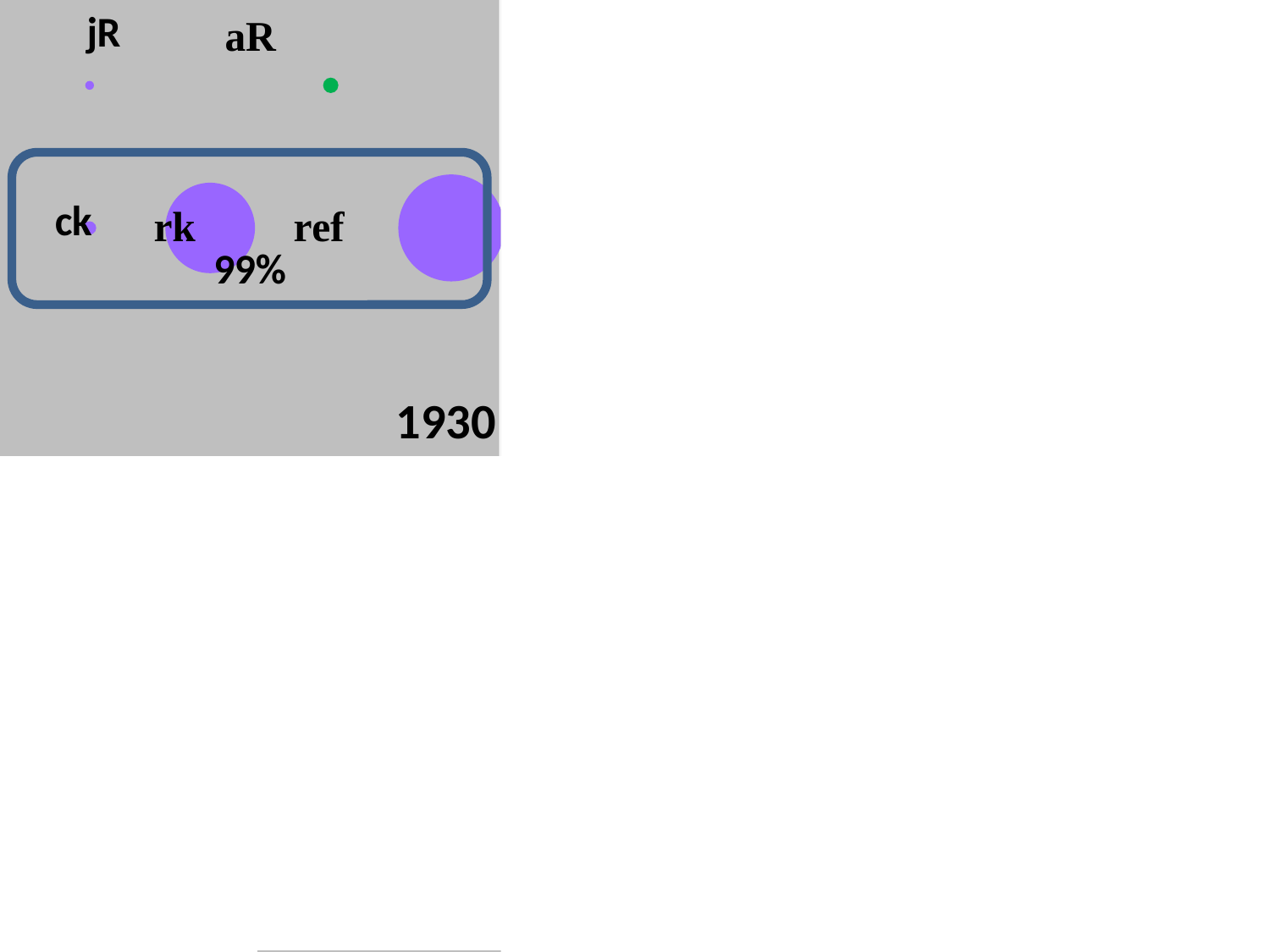
Which bubble on the chart is coloured green? aR Which bubble is larger, ref or jR? ref Which bubble is the largest on the chart? ref How many labelled bubbles are plotted on the chart? 5 What year is printed in the bottom-right corner of the chart? 1930 Which bubble is larger, rk or ck? rk What percentage label is printed inside the outlined box on the chart? 99% What kind of chart is shown on the slide? bubble chart Which bubble is larger, rk or aR? rk